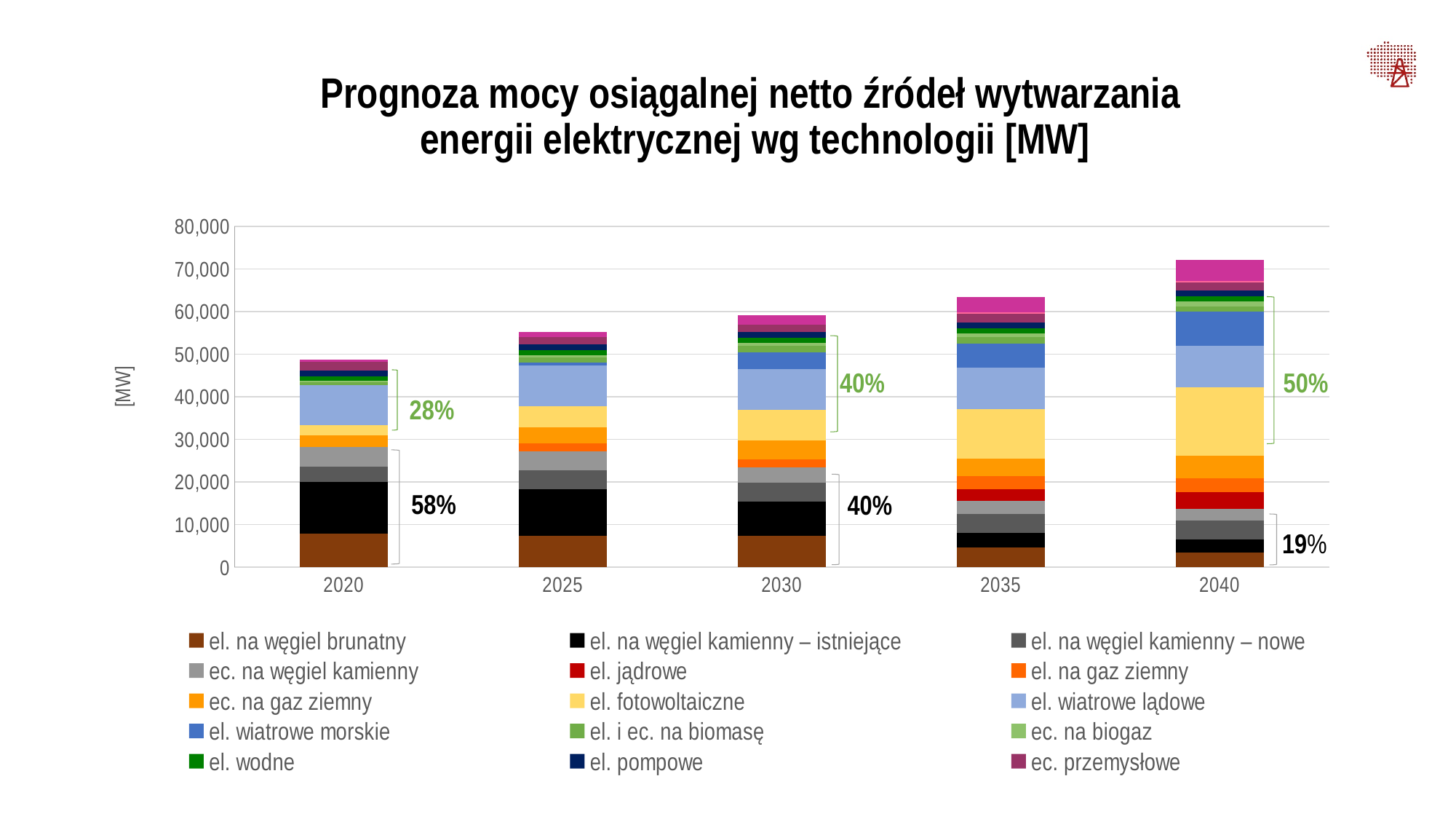
How many series does the chart legend list? 15 Which total is larger, 2040 or 2020? 2040 Is the total for 2040 greater or less than 70,000? greater Which year has the lowest total stacked bar? 2020 What percentage is printed next to the upper bracket of the 2040 bar? 50% Is the total for 2020 greater or less than 40,000? greater Which year has the highest total stacked bar? 2040 What kind of chart is shown on the slide? stacked bar chart Is the total for 2025 greater or less than 60,000? less What percentage is printed next to the lower bracket of the 2020 bar? 58% Do the total bar heights rise or fall from 2020 to 2040? rise How many years are shown on the x axis of the chart? 5